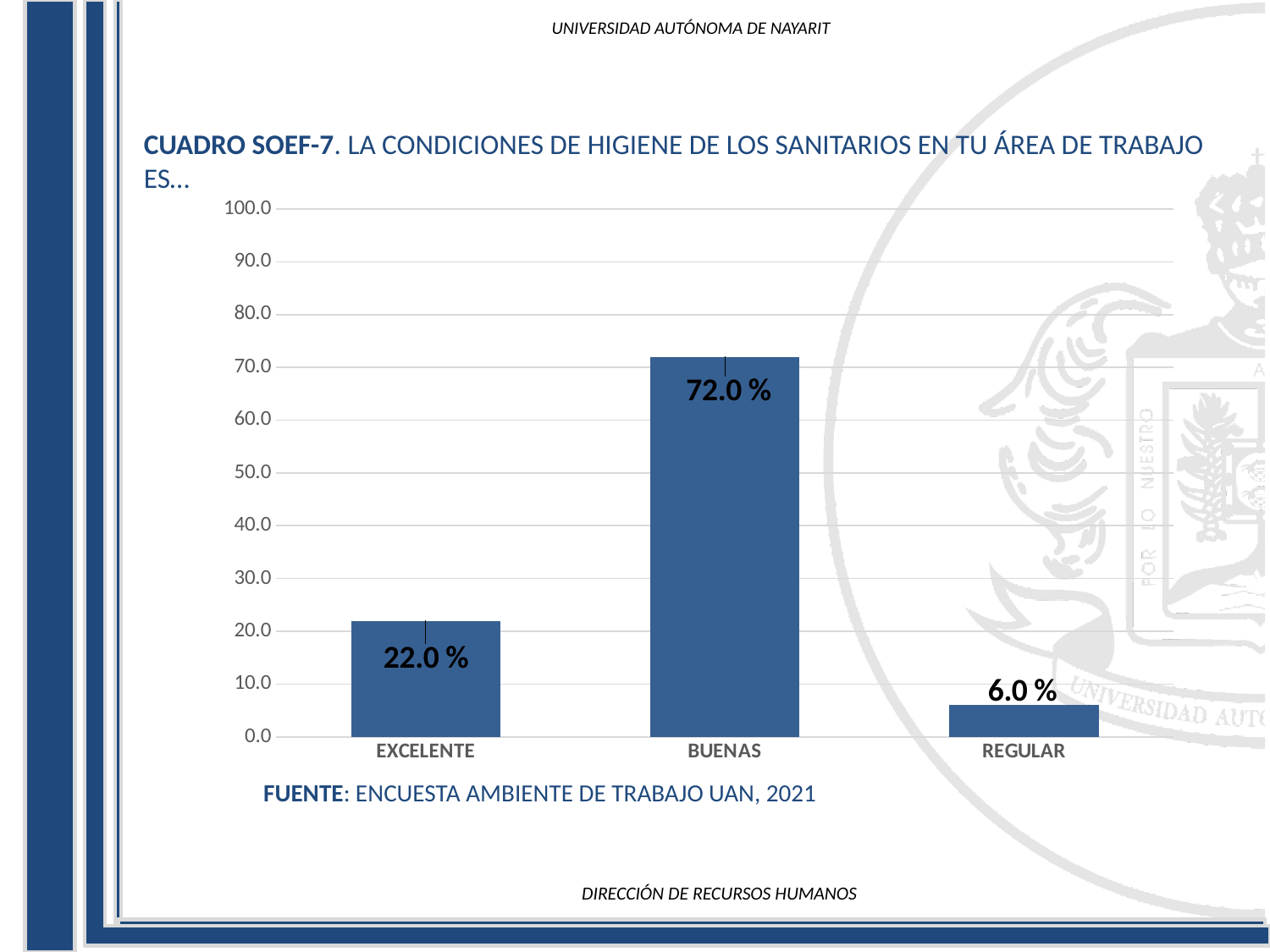
What is the difference between the values for BUENAS and EXCELENTE? 50.0 % What kind of chart is shown on the slide? bar chart What is the difference between the values for EXCELENTE and REGULAR? 16.0 % What is the value for BUENAS? 72.0 % Which category has the highest value? BUENAS What is the value for REGULAR? 6.0 % What is the source cited below the chart? ENCUESTA AMBIENTE DE TRABAJO UAN, 2021 Which is larger, the value for EXCELENTE or the value for REGULAR? EXCELENTE What is the value for EXCELENTE? 22.0 % Which category has the lowest value? REGULAR Is the value for BUENAS greater or less than 50.0? greater How many categories are shown on the x axis? 3